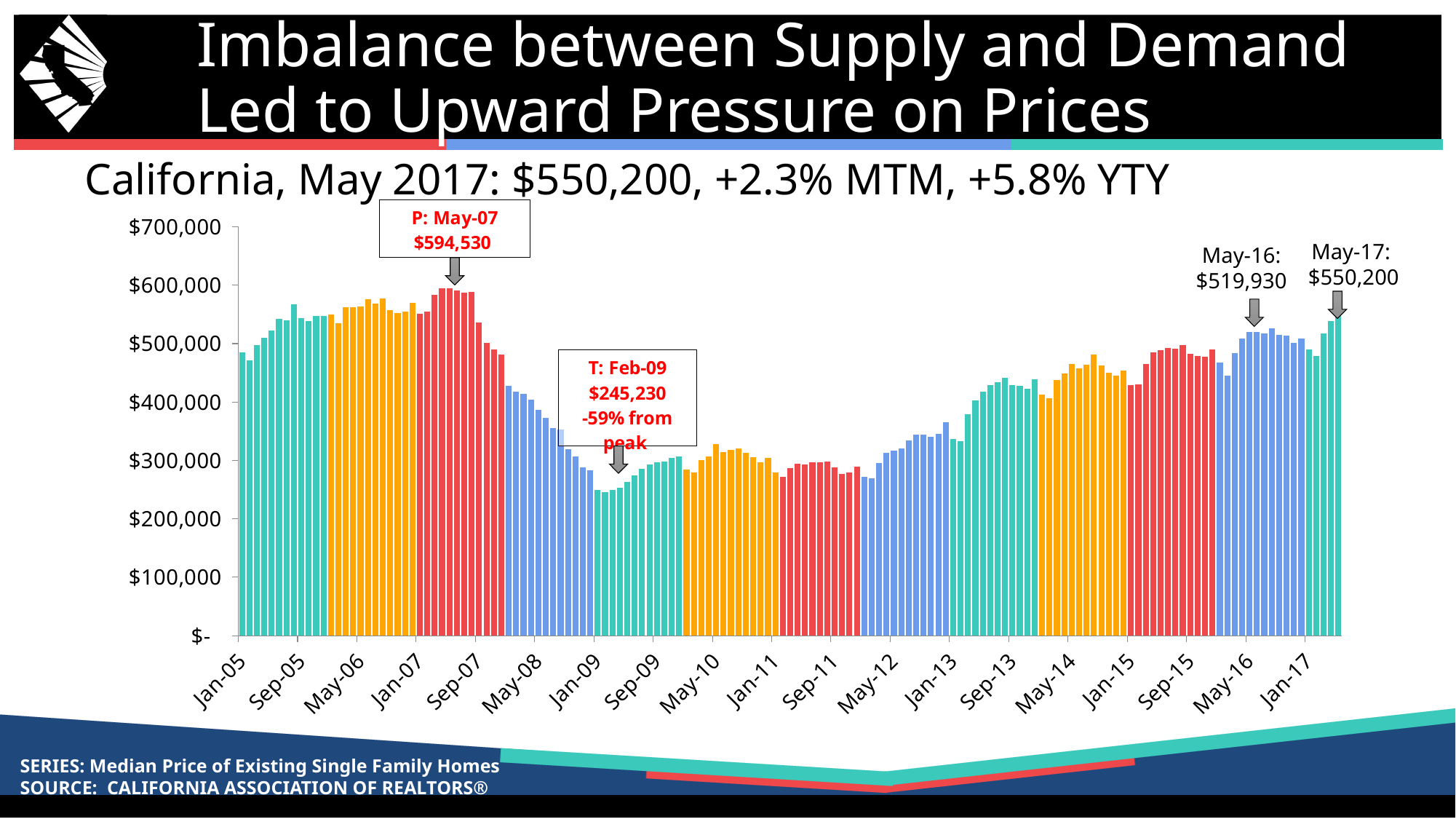
What was the median price in May-16? $519,930 How much higher was the median price in May-17 than in May-16? $30,270 In which month did the median price reach its trough? Feb-09 In which month did the median price reach its peak? May-07 What kind of chart is used to show the median price over time? bar chart Which was higher, the median price in May-16 or in May-17? May-17 What is the difference between the peak price in May-07 and the trough price in Feb-09? $349,300 Is the median price for Jan-05 greater or less than $400,000? greater What was the median price at the trough in Feb-09? $245,230 What was the median price in May-17? $550,200 By what percentage did the median price fall from the peak to the trough in Feb-09? -59% What was the median price at the peak in May-07? $594,530